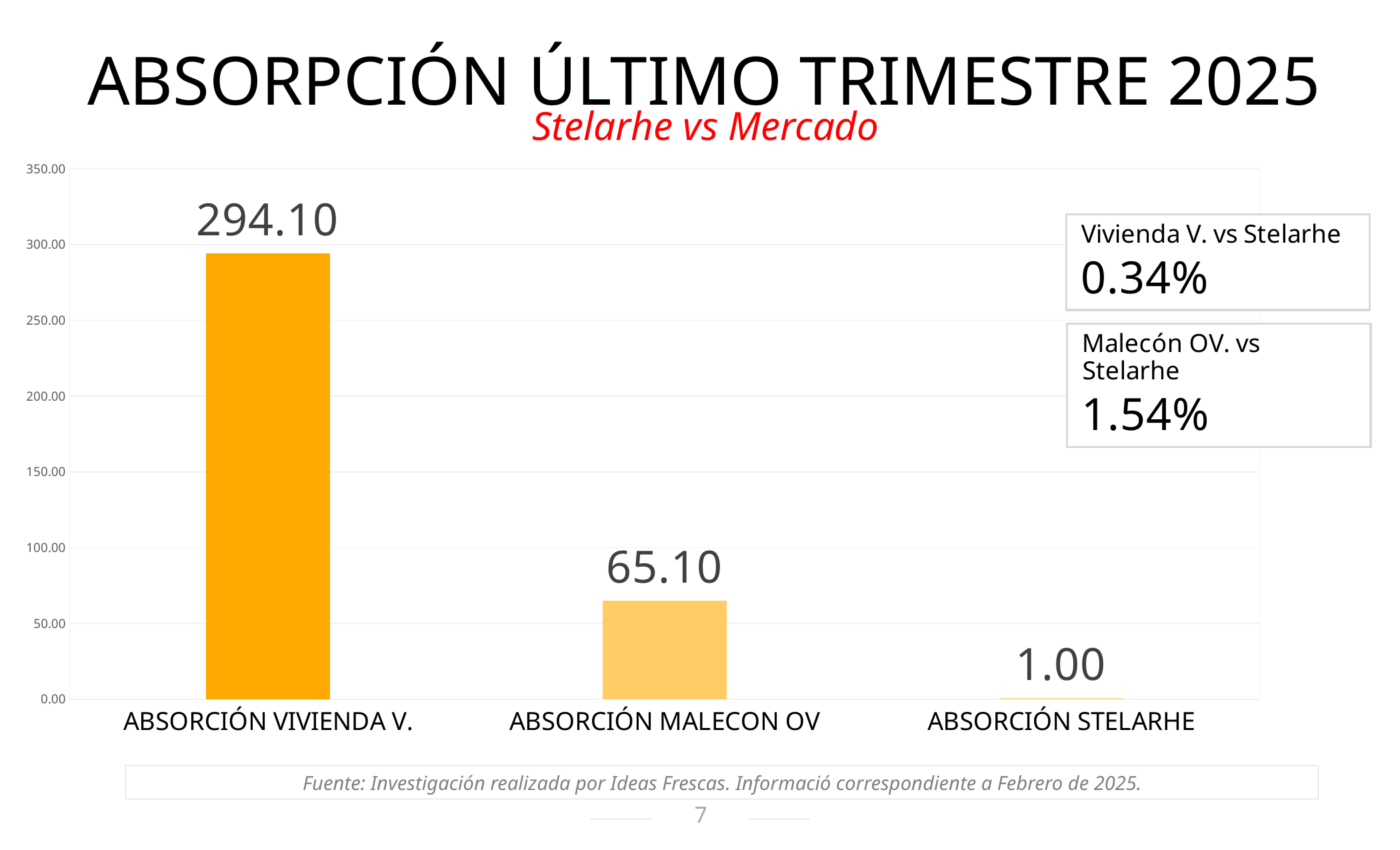
Which category has the lowest value? ABSORCIÓN STELARHE What is the red subtitle below the main title? Stelarhe vs Mercado What kind of chart is shown on the slide? bar chart What is the difference between the values for ABSORCIÓN VIVIENDA V. and ABSORCIÓN MALECON OV? 229.00 How many categories are shown in the chart? 3 Is the value for ABSORCIÓN VIVIENDA V. greater or less than 250.00? greater Which is larger, the value for ABSORCIÓN MALECON OV or ABSORCIÓN STELARHE? ABSORCIÓN MALECON OV Which category has the highest value? ABSORCIÓN VIVIENDA V. What is the value for ABSORCIÓN VIVIENDA V.? 294.10 What is the value for ABSORCIÓN STELARHE? 1.00 What is the difference between the values for ABSORCIÓN MALECON OV and ABSORCIÓN STELARHE? 64.10 What is the value for ABSORCIÓN MALECON OV? 65.10